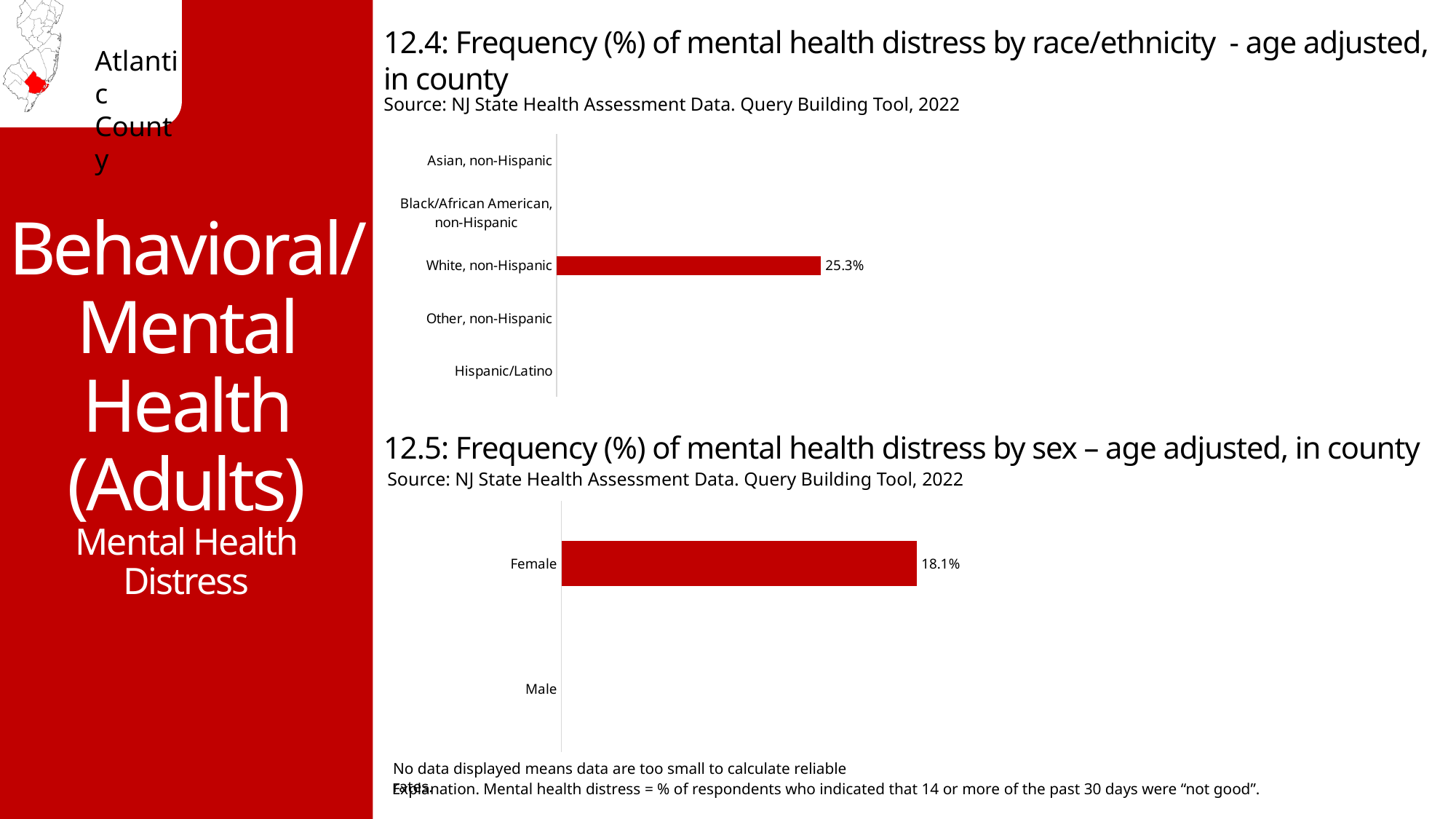
How many race/ethnicity categories are listed on the axis of the top chart (12.4)? 5 In the bottom chart (12.5), which sex category has no bar displayed? Male What kind of chart is the top chart (12.4)? Bar chart Is the value for Female in the bottom chart (12.5) greater or less than 20? less In the chart '12.5: Frequency (%) of mental health distress by sex – age adjusted, in county', what is the value for Female? 18.1% Is the value for White, non-Hispanic in the top chart (12.4) greater or less than 20? greater In the chart '12.4: Frequency (%) of mental health distress by race/ethnicity - age adjusted, in county', what is the value for White, non-Hispanic? 25.3% How many categories are listed on the axis of the bottom chart (12.5)? 2 What is the difference between the White, non-Hispanic value in chart 12.4 and the Female value in chart 12.5? 7.2 percentage points In the top chart (12.4), which race/ethnicity category is the only one with a bar displayed? White, non-Hispanic Which is larger: the White, non-Hispanic value in chart 12.4 or the Female value in chart 12.5? White, non-Hispanic (25.3%) What kind of chart is the bottom chart (12.5)? Bar chart